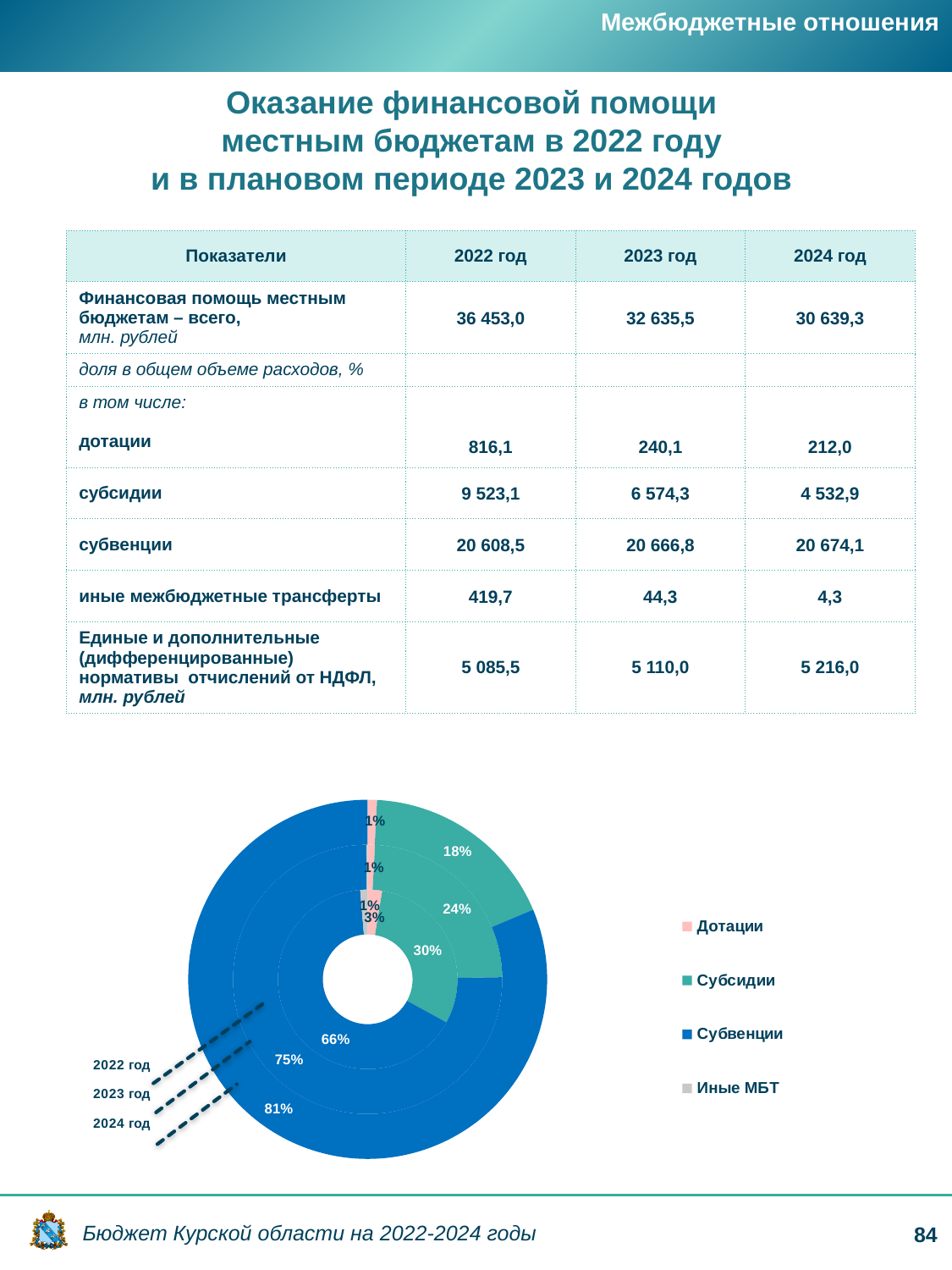
In the doughnut chart, what share do Субвенции have in the 2024 ring? 81% What kind of chart is shown at the bottom of the slide? Doughnut chart In the doughnut chart, what share do Субсидии have in the 2022 ring? 30% Does the share of Субвенции rise or fall from the 2022 ring to the 2024 ring? Rises How many rings (years) does the doughnut chart have? 3 Which colour represents Субвенции in the doughnut chart? Blue Does the share of Субсидии rise or fall from the 2022 ring to the 2024 ring? Falls How many entries does the legend of the doughnut chart list? 4 By how many percentage points is the Субвенции share in the 2024 ring larger than in the 2022 ring? 15 In the doughnut chart, what share do Субсидии have in the 2024 ring? 18% Which category has the largest share in the 2024 ring of the doughnut chart? Субвенции In the doughnut chart, what share do Субвенции have in the 2023 ring? 75%